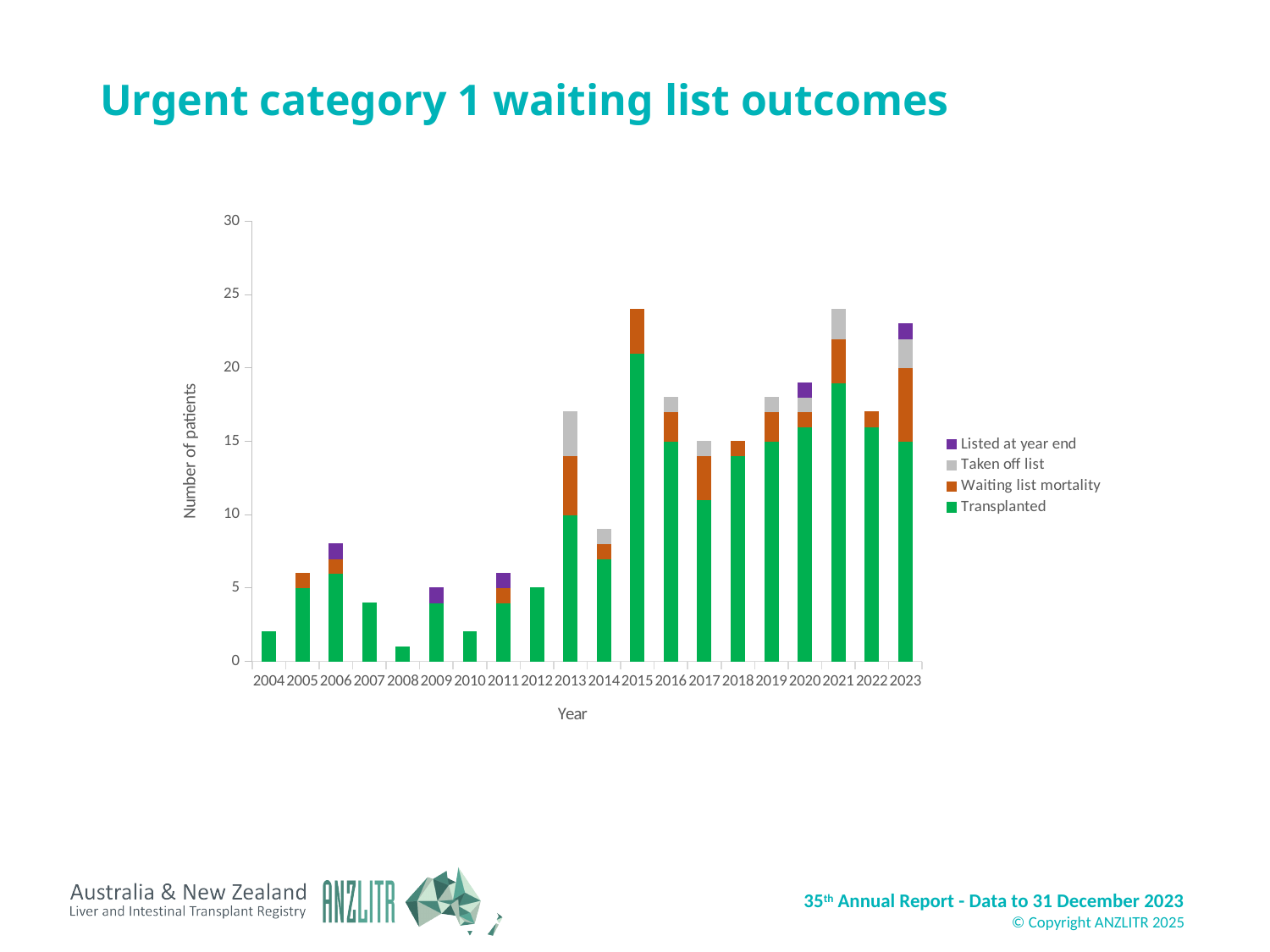
Which year has the larger total number of patients, 2015 or 2014? 2015 Do the total numbers of patients rise or fall from 2012 to 2015? rise What kind of chart is shown on the slide? Stacked bar chart Which series is shown in green in the legend? Transplanted Is the total number of patients in 2014 greater or less than 10? less Is the number of transplanted patients in 2021 greater or less than 15? greater Is the total number of patients in 2015 greater or less than 20? greater Which year has the larger total number of patients, 2007 or 2013? 2013 How many series does the legend list? 4 How many years are shown along the x axis of the chart? 20 Which year has the lowest total number of patients? 2008 What is the title of the chart? Urgent category 1 waiting list outcomes